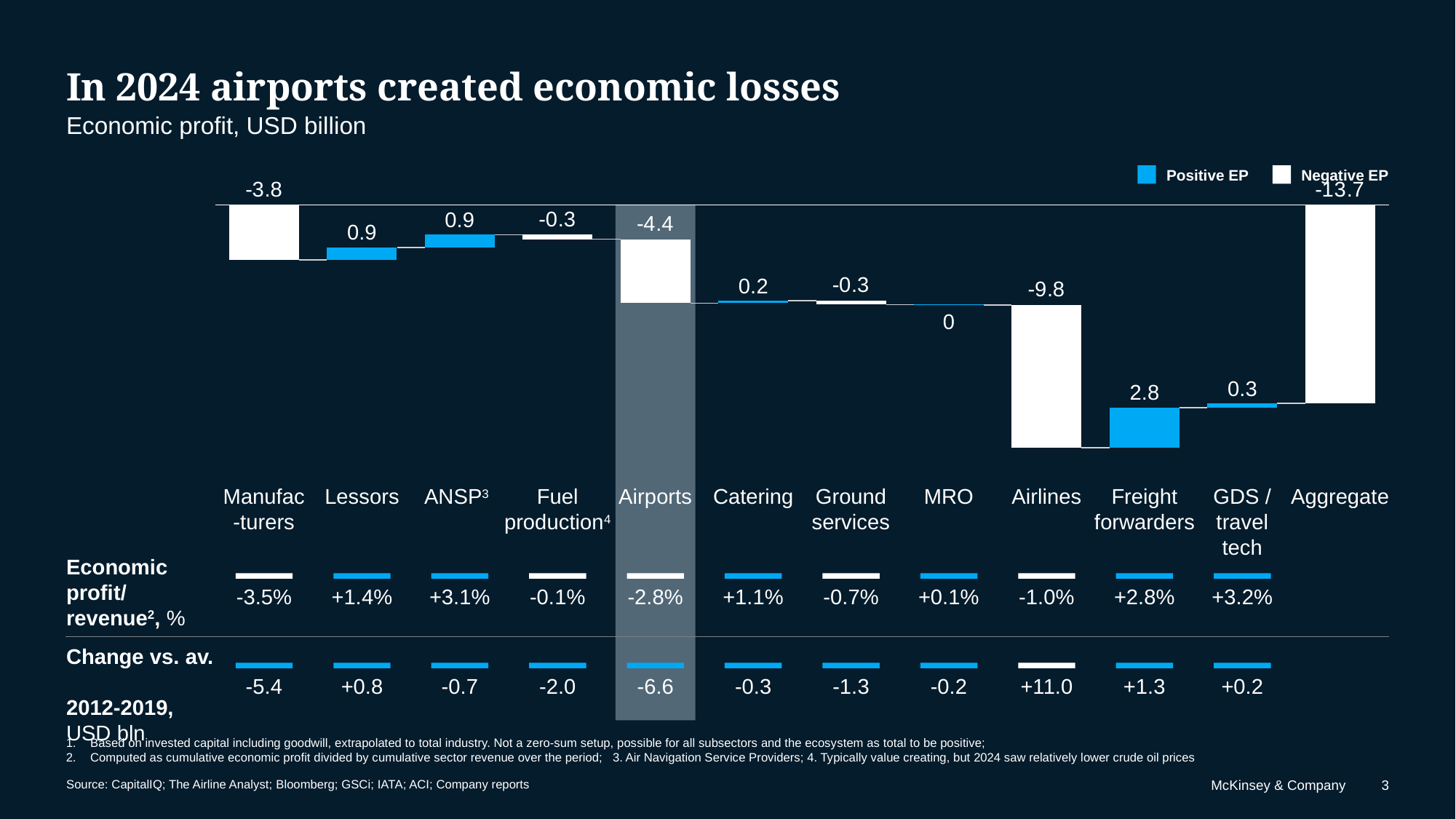
What kind of chart is shown on the slide? Bar chart (waterfall) What is the title of the slide's chart? In 2024 airports created economic losses Excluding the Aggregate bar, which sector has the lowest economic profit? Airlines Which has a larger economic profit, Lessors or Freight forwarders? Freight forwarders What is the economic profit for Airlines in USD billion? -9.8 What is the difference between the economic profit of Airlines and Airports, in USD billion? 5.4 What is the Aggregate economic profit shown at the right of the chart? -13.7 How many bars are plotted in the chart, including the Aggregate bar? 12 How many entries does the legend list? 2 Which sector has the highest economic profit? Freight forwarders What is the economic profit for Freight forwarders? 2.8 What is the economic profit for Airports in USD billion? -4.4